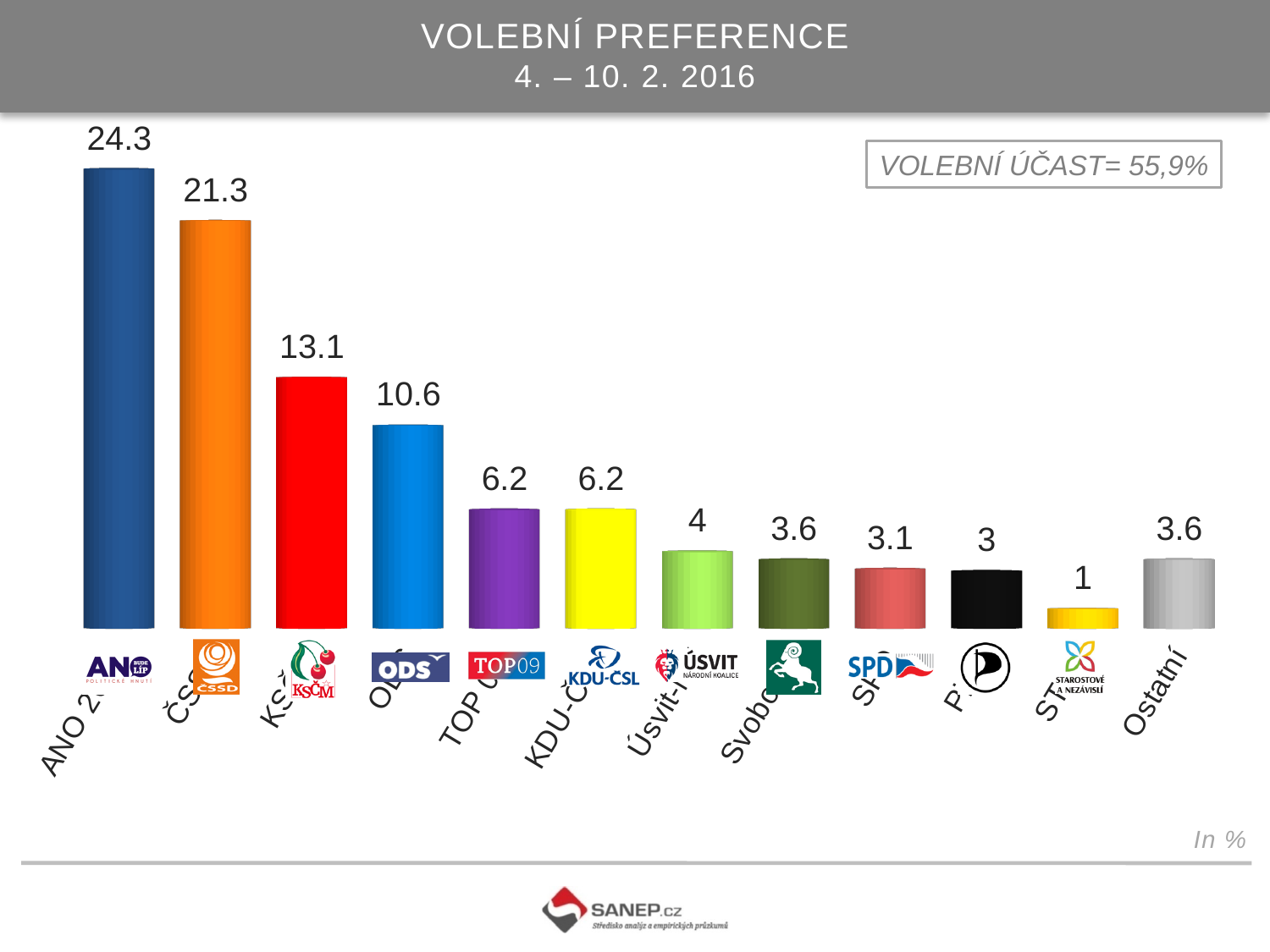
How many bars are shown in the chart? 12 What is the value shown for KDU-ČSL? 6.2 What is the value shown for ČSSD? 21.3 Which bar has the lowest value in the chart? Starostové a nezávislí (STAN) What is the difference between the values for KSČM and ODS? 2.5 What is the value shown for ANO 2011? 24.3 Which party has the highest value in the chart? ANO 2011 What is the value shown for ODS? 10.6 Which has a larger value, KSČM or ODS? KSČM What kind of chart is shown on the slide? Bar chart What is the value shown for Ostatní? 3.6 What is the difference between the values for ANO 2011 and ČSSD? 3